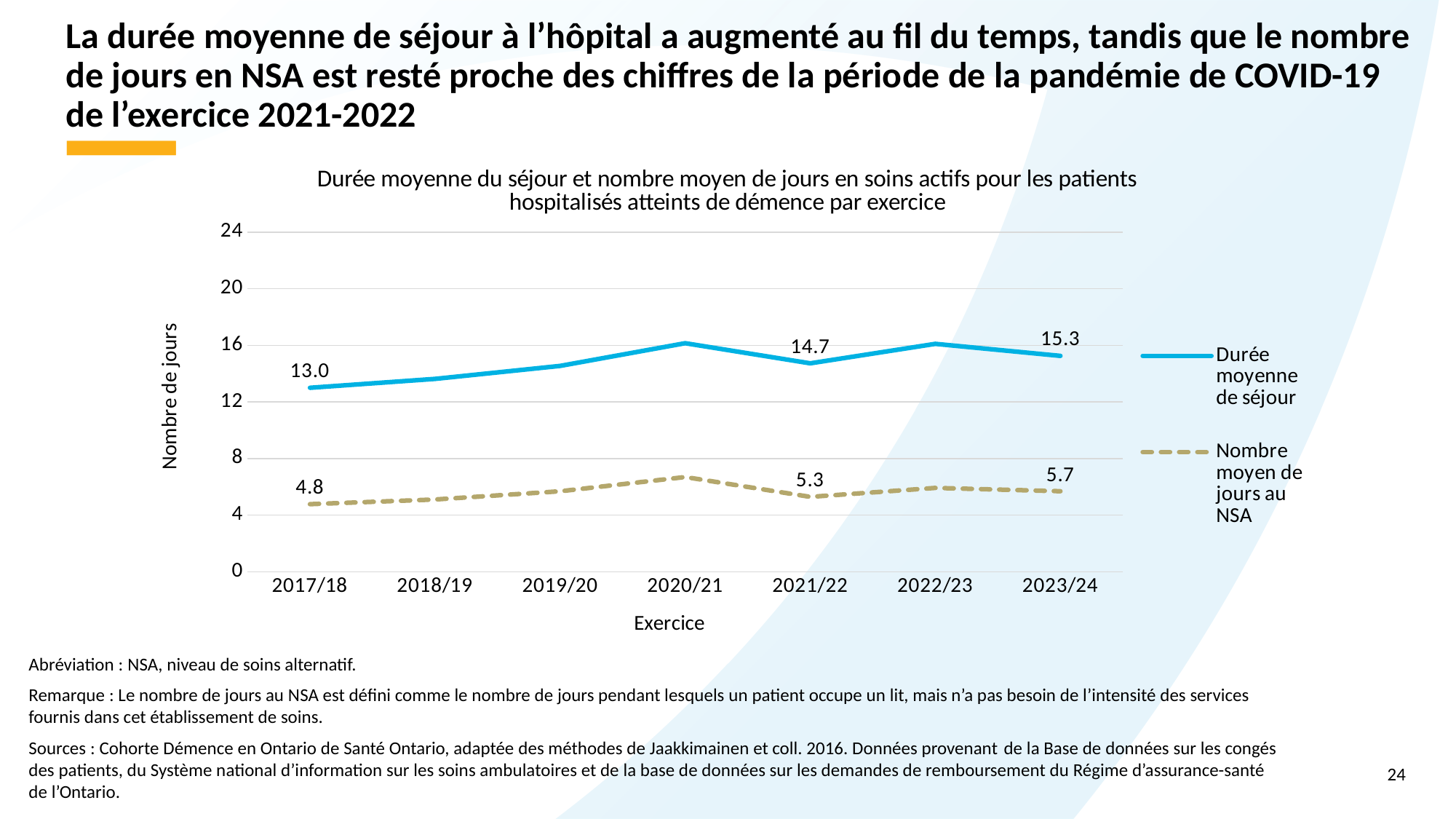
What is the value of Durée moyenne de séjour for 2017/18? 13.0 How many fiscal years (exercices) are shown on the x axis? 7 Is the value of Nombre moyen de jours au NSA for 2020/21 greater or less than 8? less What is the value of Nombre moyen de jours au NSA for 2021/22? 5.3 What kind of chart is shown on the slide? line chart By how much did Durée moyenne de séjour increase from 2017/18 to 2023/24? 2.3 What is the value of Nombre moyen de jours au NSA for 2017/18? 4.8 Is the value of Durée moyenne de séjour for 2019/20 greater or less than 16? less Which year has the higher Durée moyenne de séjour, 2021/22 or 2023/24? 2023/24 What is the difference between the Nombre moyen de jours au NSA values for 2023/24 and 2017/18? 0.9 How many series does the legend list? 2 What is the value of Durée moyenne de séjour for 2023/24? 15.3